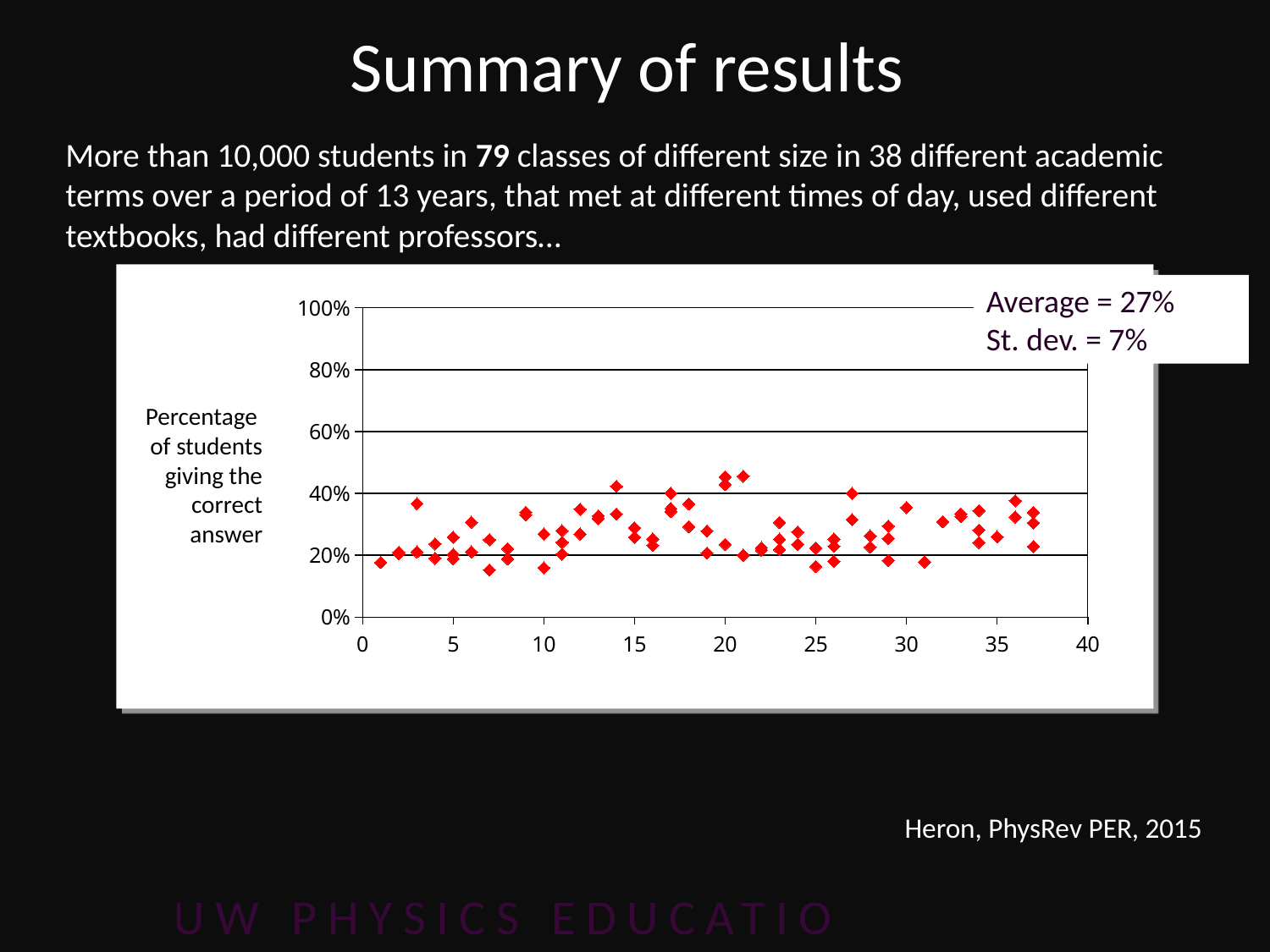
Do the plotted values show a clear rising or falling trend along the x axis? no clear trend What standard deviation is stated on the chart? 7% What colour are the data markers on the chart? red Is the lowest plotted point greater or less than 20%? less Is the highest plotted point greater or less than 40%? greater Is the highest plotted point greater or less than 60%? less What does the y axis of the chart represent? Percentage of students giving the correct answer What average value is stated on the chart? 27% What kind of chart is shown on the slide? scatter chart